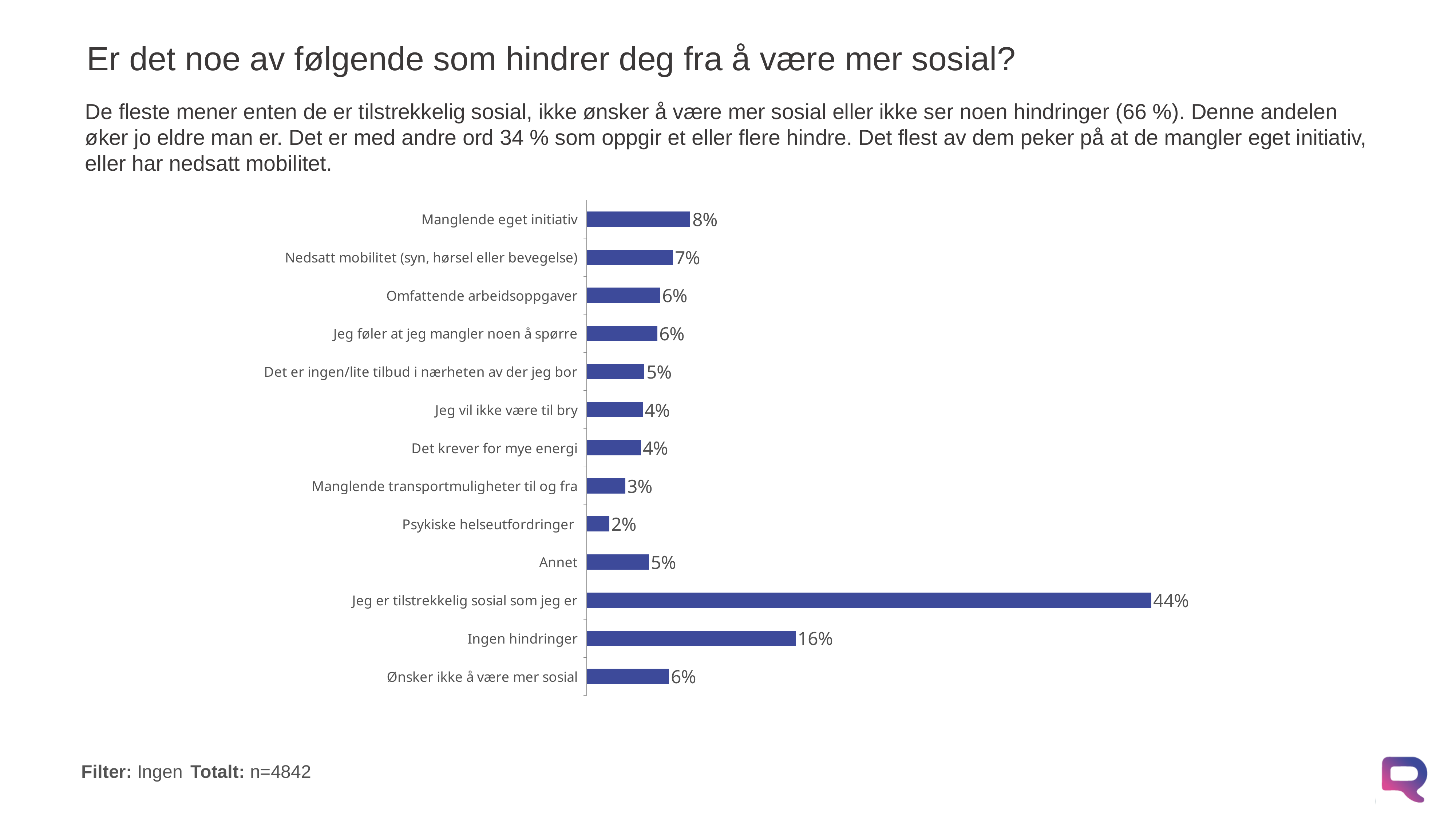
What type of chart is shown on the slide? Bar chart What value is shown for "Nedsatt mobilitet (syn, hørsel eller bevegelse)"? 7% Which category has the highest value in the chart? Jeg er tilstrekkelig sosial som jeg er What is the difference between "Jeg er tilstrekkelig sosial som jeg er" and "Ingen hindringer"? 28 percentage points What percentage is shown for "Manglende eget initiativ"? 8% Which category has the lowest value in the chart? Psykiske helseutfordringer What is the sample size (n) stated at the bottom of the slide? n=4842 Which is larger: "Manglende eget initiativ" or "Manglende transportmuligheter til og fra"? Manglende eget initiativ What is the difference between "Manglende eget initiativ" and "Psykiske helseutfordringer"? 6 percentage points What percentage is shown for "Psykiske helseutfordringer"? 2% How many categories are shown in the chart? 13 What value does the bar for "Ingen hindringer" show? 16%